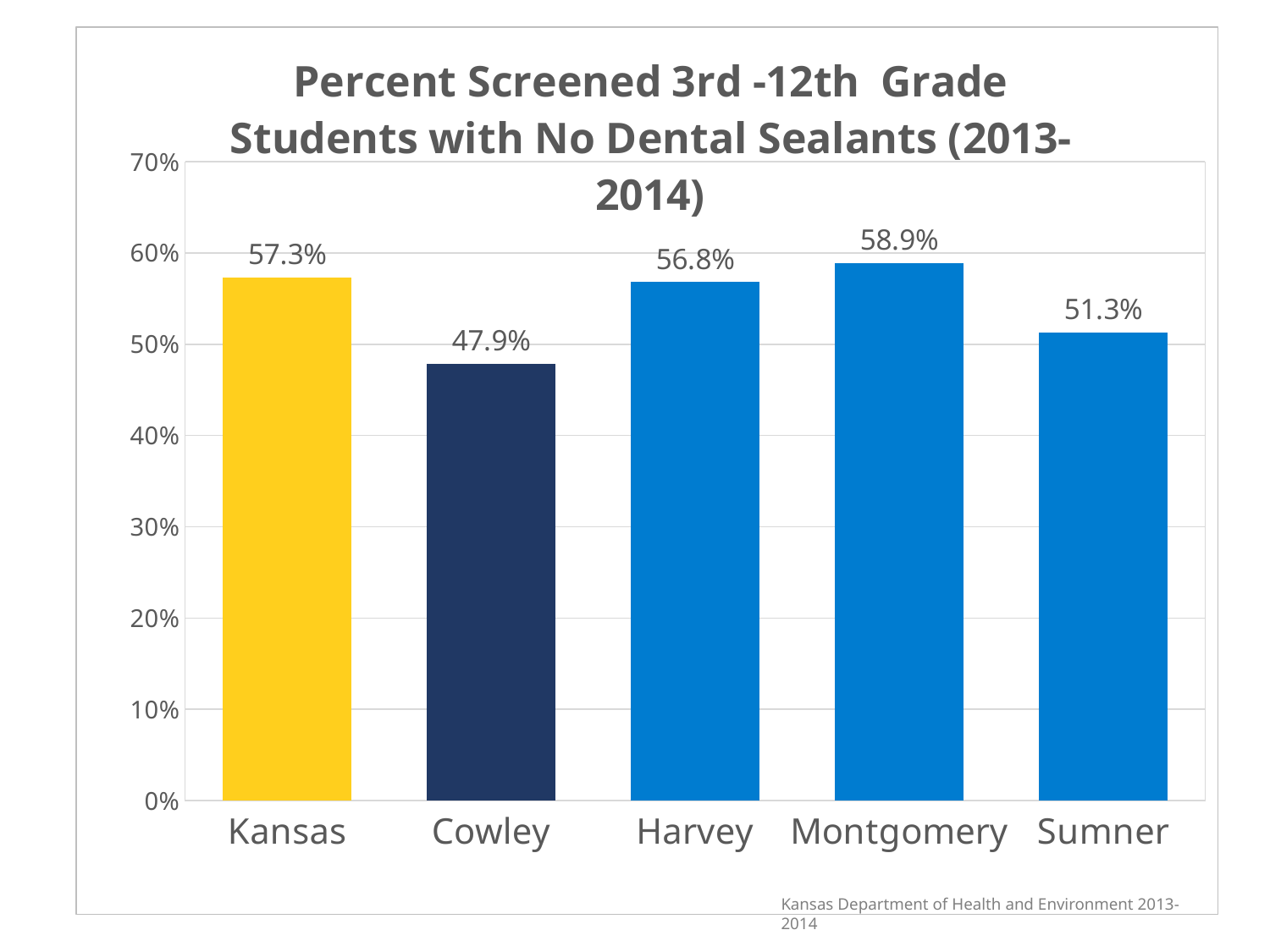
What is the difference between the values for Kansas and Sumner? 6.0% What is the value for Montgomery? 58.9% What kind of chart is shown on the slide? Bar chart Which is larger, the value for Harvey or the value for Sumner? Harvey What is the value for Sumner? 51.3% What is the value for Cowley? 47.9% Which category has the highest value? Montgomery What is the value for Kansas? 57.3% What is the difference between the values for Montgomery and Cowley? 11.0% Is the value for Cowley greater or less than 50%? less Which category has the lowest value? Cowley How many categories are shown on the x axis? 5